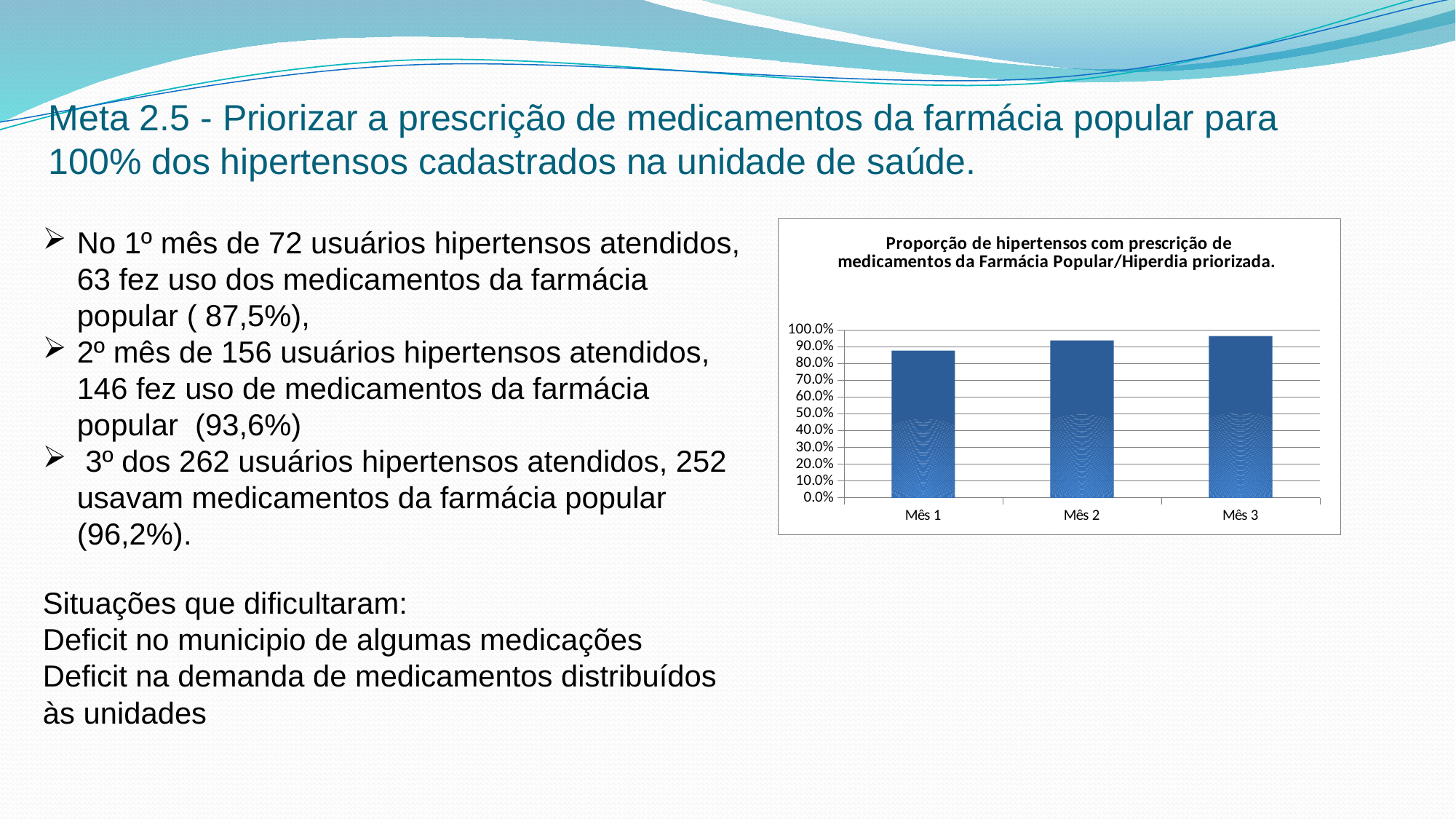
Which month has the lowest proportion in the chart? Mês 1 What kind of chart is shown on the slide? bar chart How many months (categories) are plotted in the chart? 3 Do the values rise or fall from Mês 1 to Mês 3? rise Is the value for Mês 2 greater or less than 90.0%? greater What is the highest value shown on the chart's vertical axis? 100.0% What is the title of the chart? Proporção de hipertensos com prescrição de medicamentos da Farmácia Popular/Hiperdia priorizada. Is the value for Mês 3 greater or less than 90.0%? greater Which is larger, the value for Mês 1 or the value for Mês 2? Mês 2 Is the value for Mês 1 greater or less than 90.0%? less